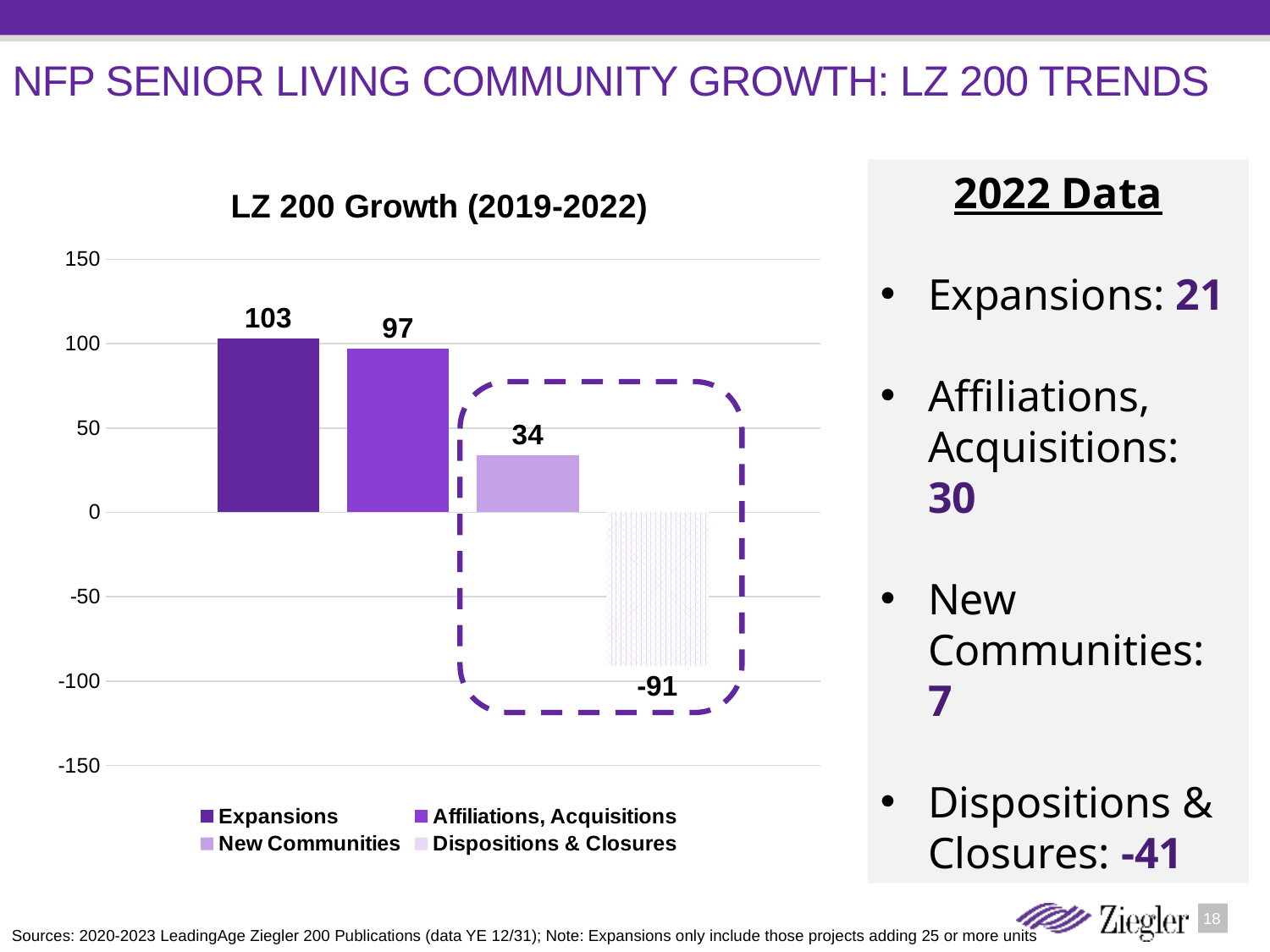
What is the difference between the Affiliations, Acquisitions value and the New Communities value? 63 What is the value for Affiliations, Acquisitions in the chart? 97 What is the value for Expansions in the LZ 200 Growth (2019-2022) chart? 103 What is the value for New Communities in the chart? 34 Which series has the lowest value in the chart? Dispositions & Closures How many series does the legend list? 4 What is the value for Dispositions & Closures in the chart? -91 Which series has the highest value in the chart? Expansions What is the title of the chart? LZ 200 Growth (2019-2022) What is the difference between the Expansions value and the Affiliations, Acquisitions value? 6 Which is larger, the value for Expansions or the value for New Communities? Expansions What kind of chart is shown on the slide? Bar chart